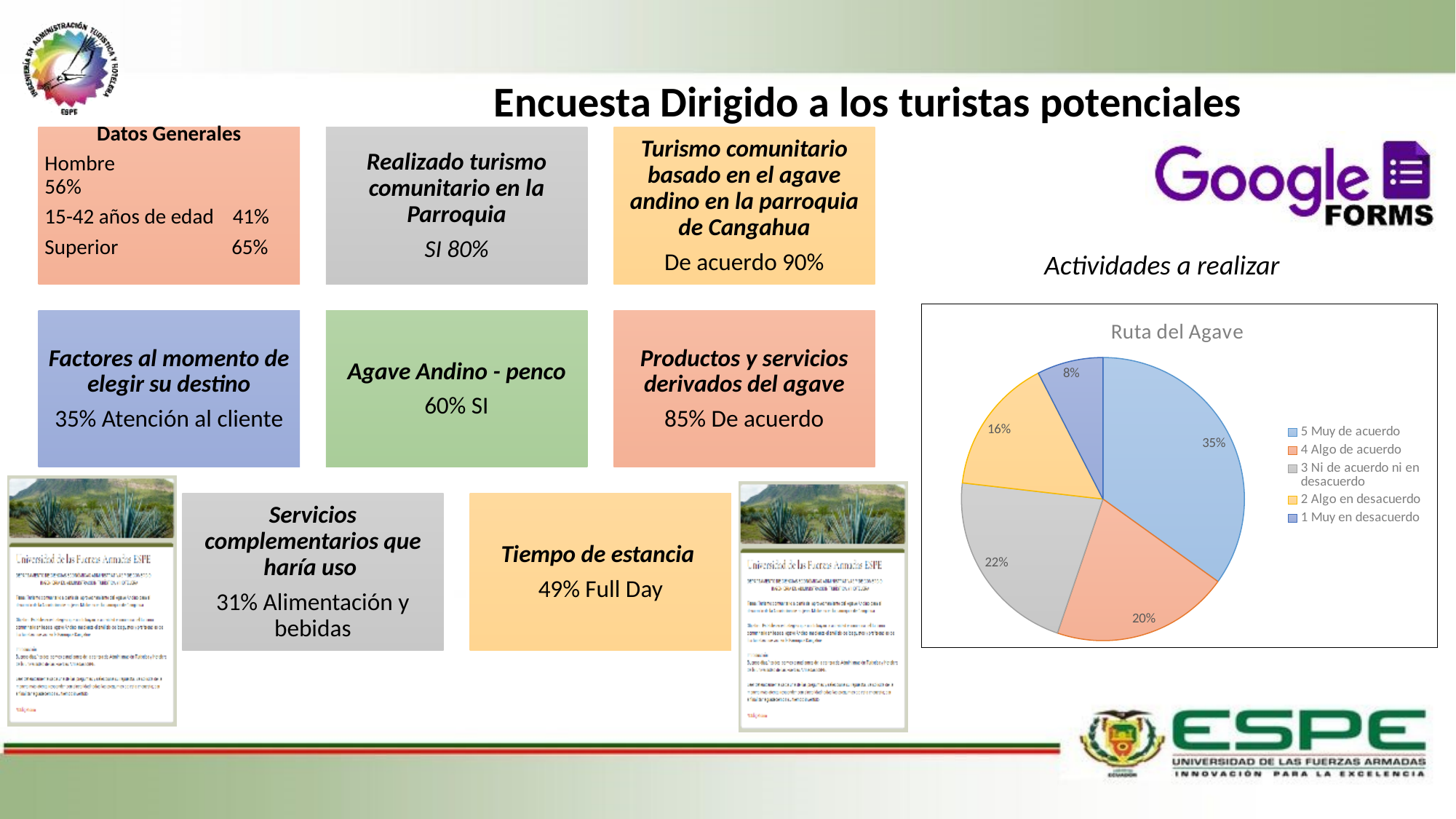
In the "Ruta del Agave" pie chart, which is larger: "3 Ni de acuerdo ni en desacuerdo" or "4 Algo de acuerdo"? 3 Ni de acuerdo ni en desacuerdo What is the title of the pie chart on the slide? Ruta del Agave In the "Ruta del Agave" pie chart, what percentage is shown for "4 Algo de acuerdo"? 20% Which category has the smallest slice in the "Ruta del Agave" pie chart? 1 Muy en desacuerdo In the "Ruta del Agave" pie chart, what percentage is shown for "1 Muy en desacuerdo"? 8% In the "Ruta del Agave" pie chart, what percentage is shown for "2 Algo en desacuerdo"? 16% In the "Ruta del Agave" pie chart, what percentage is shown for "3 Ni de acuerdo ni en desacuerdo"? 22% Which category has the largest slice in the "Ruta del Agave" pie chart? 5 Muy de acuerdo In the "Ruta del Agave" pie chart, what is the difference in percentage points between "5 Muy de acuerdo" and "1 Muy en desacuerdo"? 27 What type of chart is shown under the title "Ruta del Agave"? pie chart How many categories does the legend of the "Ruta del Agave" pie chart list? 5 In the "Ruta del Agave" pie chart, what percentage is shown for "5 Muy de acuerdo"? 35%